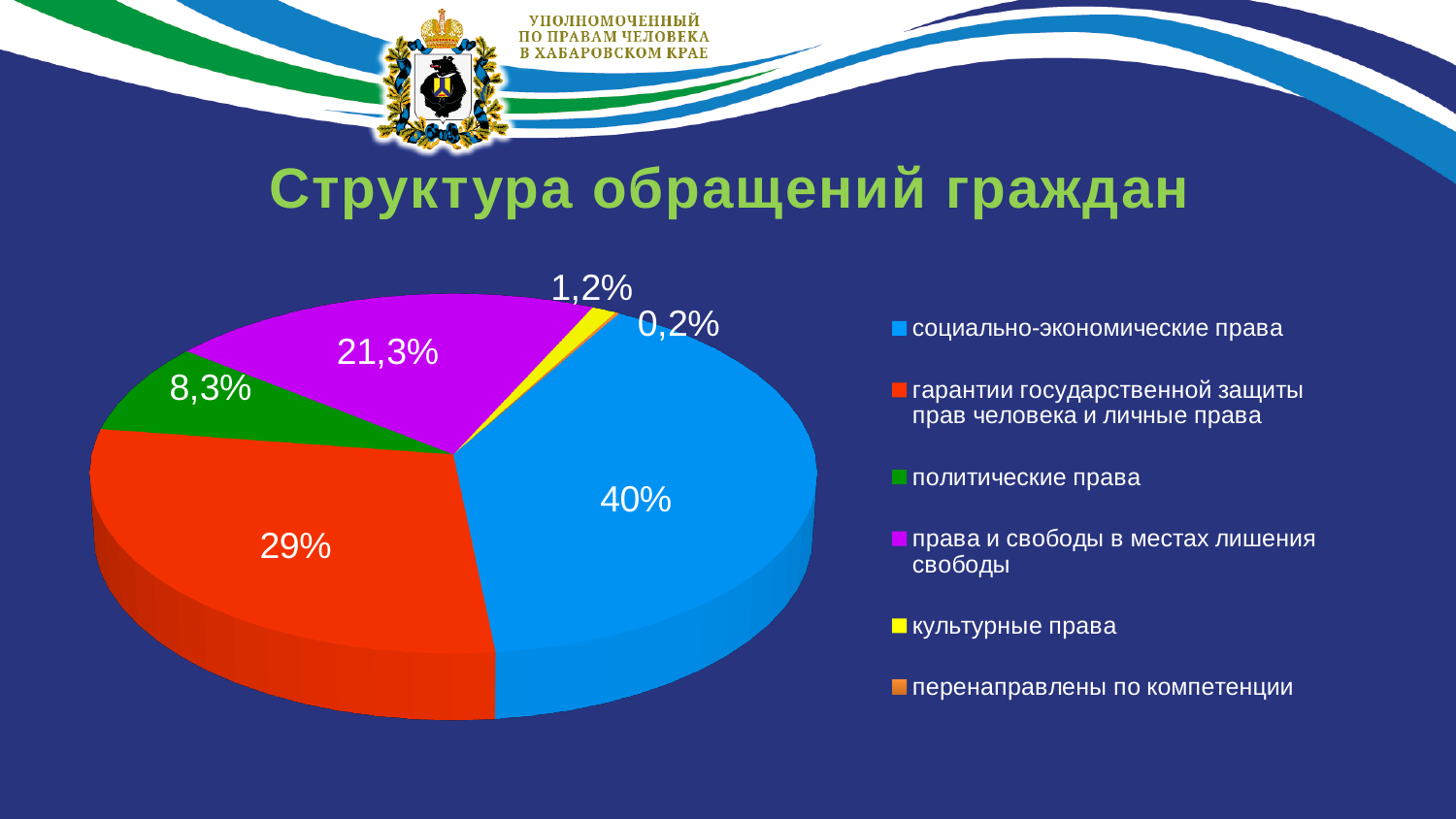
What share of the pie is labelled for права и свободы в местах лишения свободы? 21,3% What share of the pie is labelled for перенаправлены по компетенции? 0,2% What share of the pie is labelled for социально-экономические права? 40% How many categories does the legend list? 6 What is the title of the chart? Структура обращений граждан What type of chart is shown on the slide? pie chart Which category has the largest share of the pie? социально-экономические права Which category has the smallest share of the pie? перенаправлены по компетенции What share of the pie is labelled for политические права? 8,3% What share of the pie is labelled for культурные права? 1,2% Which is larger: the share for политические права or the share for права и свободы в местах лишения свободы? права и свободы в местах лишения свободы What share of the pie is labelled for гарантии государственной защиты прав человека и личные права? 29%